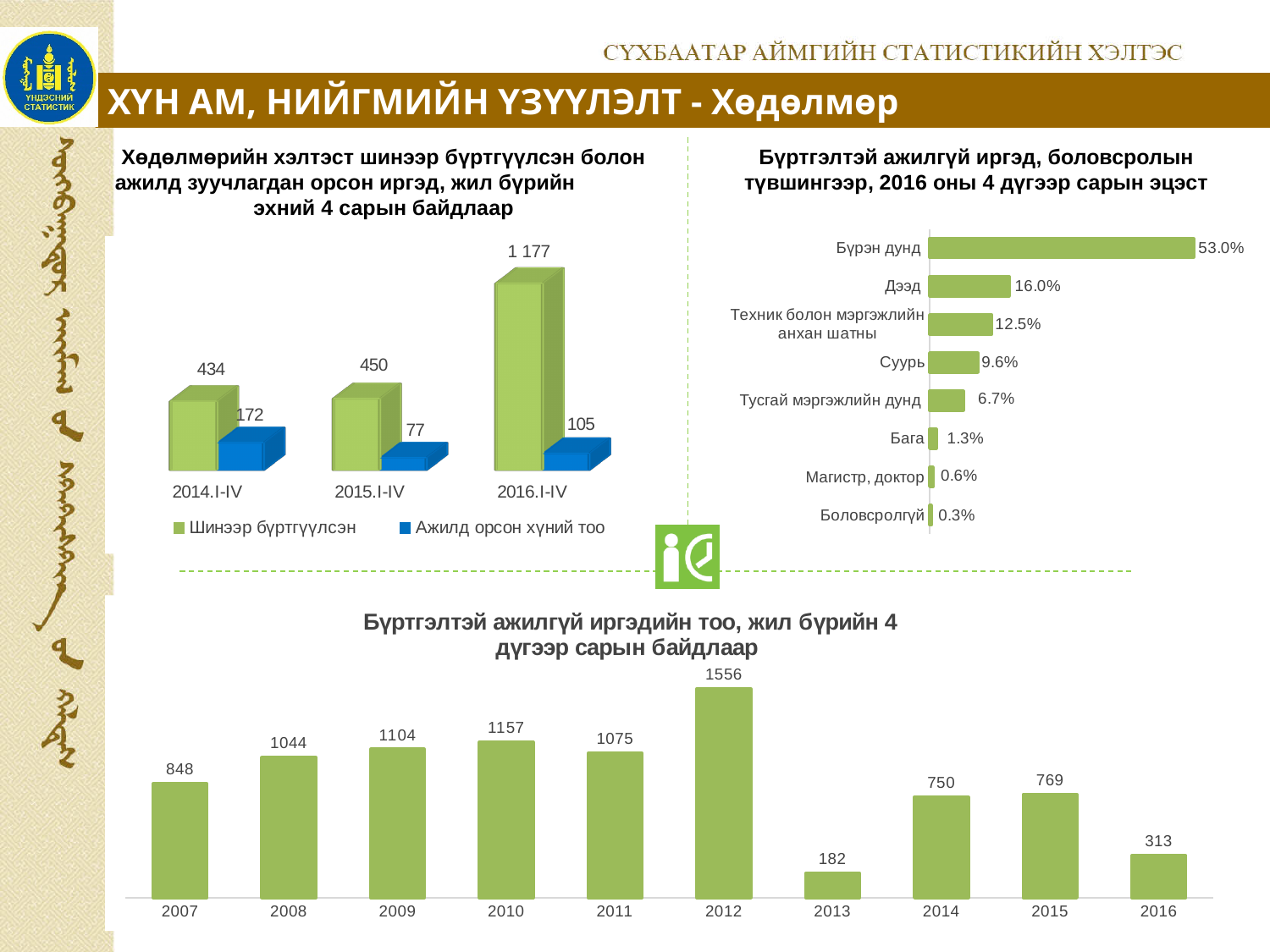
In the top-right chart, which is larger: 'Суурь' or 'Тусгай мэргэжлийн дунд'? Суурь In the top-right chart, what is the value for 'Бүрэн дунд'? 53.0% In the bottom chart, what is the difference between the values for 2015 and 2016? 456 What kind of chart is the bottom chart? Bar chart In the top-left chart, what is the value for 'Шинээр бүртгүүлсэн' in 2016.I-IV? 1 177 How many categories are shown in the top-right chart? 8 How many series does the legend of the top-left chart list? 2 In the bottom chart, which year has the highest value? 2012 In the top-right chart, which category has the lowest value? Боловсролгүй In the top-left chart, what is the value for 'Ажилд орсон хүний тоо' in 2015.I-IV? 77 In the bottom chart, what is the value for 2013? 182 In the top-left chart, what is the difference between 'Шинээр бүртгүүлсэн' and 'Ажилд орсон хүний тоо' in 2014.I-IV? 262